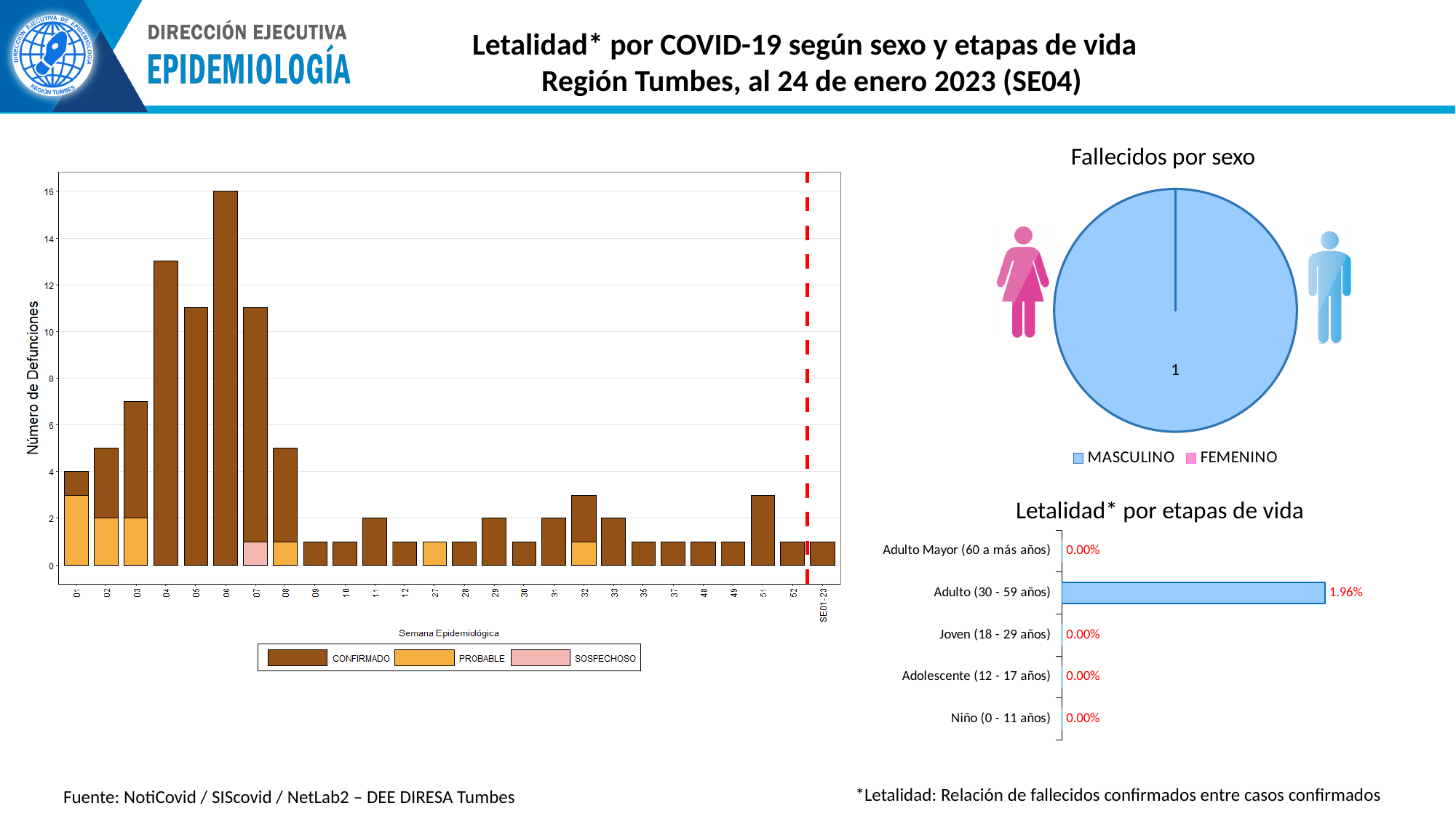
In the bar chart on the left, is the total number of deaths for week 04 greater or less than 12? greater In the 'Fallecidos por sexo' pie chart, what value is shown as the data label on the pie? 1 What kind of chart is 'Fallecidos por sexo'? Pie chart How many age groups are shown in the 'Letalidad* por etapas de vida' chart? 5 In the 'Letalidad* por etapas de vida' chart, what is the value for Niño (0 - 11 años)? 0.00% How many entries does the legend of the 'Fallecidos por sexo' chart list? 2 In the bar chart on the left, which week has more deaths, 02 or 03? 03 In the 'Letalidad* por etapas de vida' chart, what is the value for Adulto (30 - 59 años)? 1.96% In the 'Letalidad* por etapas de vida' chart, which age group has the highest value? Adulto (30 - 59 años) In the 'Letalidad* por etapas de vida' chart, what is the difference between the values for Adulto (30 - 59 años) and Joven (18 - 29 años)? 1.96% In the bar chart on the left, how many series does the legend list? 3 In the bar chart on the left (Número de Defunciones by Semana Epidemiológica), which week has the highest number of deaths? 06